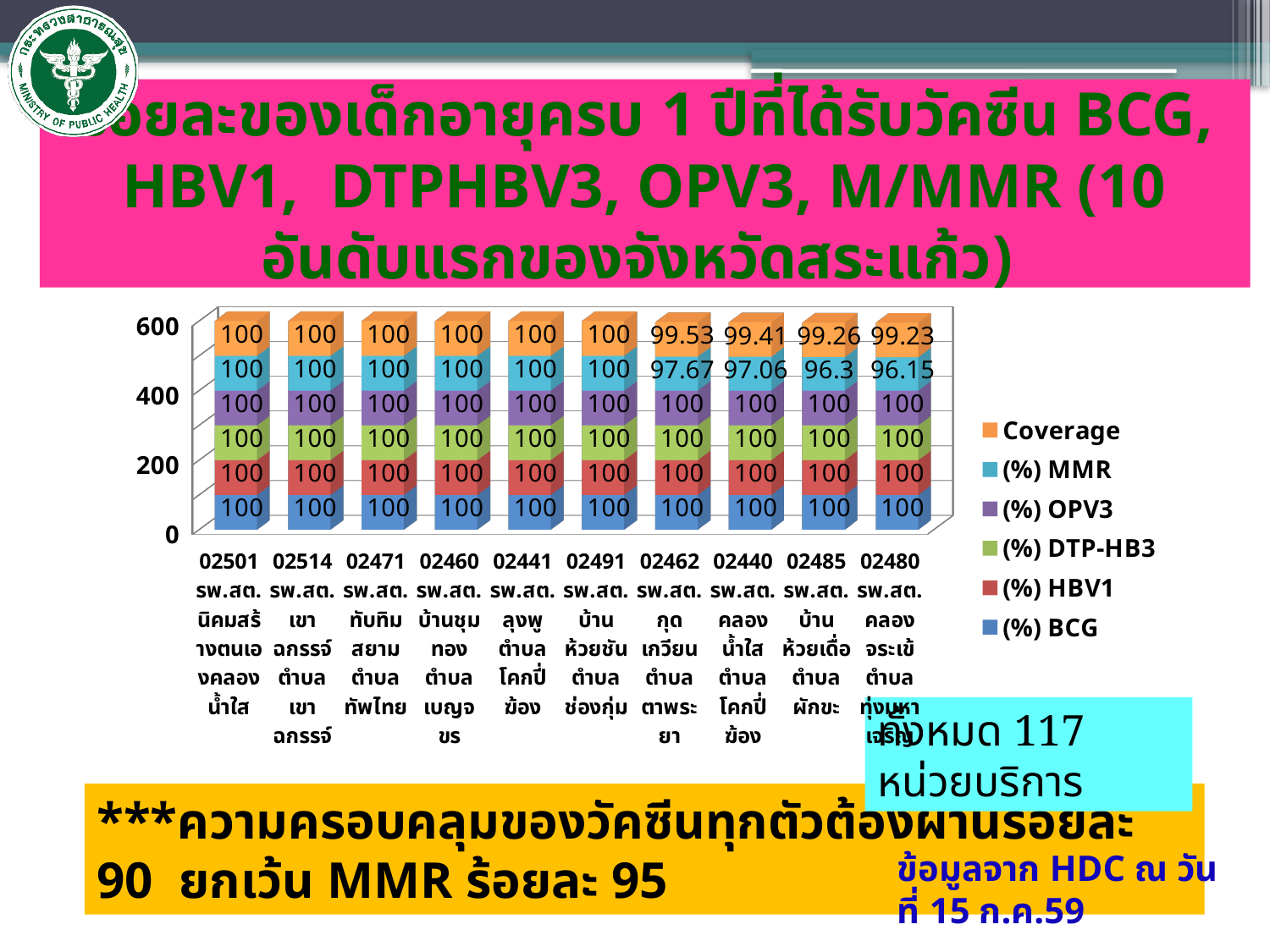
Which category has the lowest (%) MMR value? 02480 รพ.สต.คลองจระเข้ ตำบลทุ่งมหาเจริญ What kind of chart is shown on the slide? stacked bar chart What is the (%) BCG value for 02501 รพ.สต.นิคมสร้างตนเองคลองน้ำใส? 100 What is the (%) MMR value for 02462 รพ.สต.กุดเกวียน ตำบลตาพระยา? 97.67 How many series does the chart legend list? 6 Which colour represents the Coverage series in the legend? orange What is the (%) MMR value for 02485 รพ.สต.บ้านห้วยเดื่อ ตำบลผักขะ? 96.3 How many health service units (categories) are plotted on the x axis? 10 What is the difference between the Coverage values for 02462 รพ.สต.กุดเกวียน and 02480 รพ.สต.คลองจระเข้? 0.3 What is the total of the stacked bar for 02514 รพ.สต.เขาฉกรรจ์ ตำบลเขาฉกรรจ์? 600 Which is larger, the (%) MMR value for 02440 รพ.สต.คลองน้ำใส or for 02485 รพ.สต.บ้านห้วยเดื่อ? 02440 รพ.สต.คลองน้ำใส What is the Coverage value for 02480 รพ.สต.คลองจระเข้ ตำบลทุ่งมหาเจริญ? 99.23